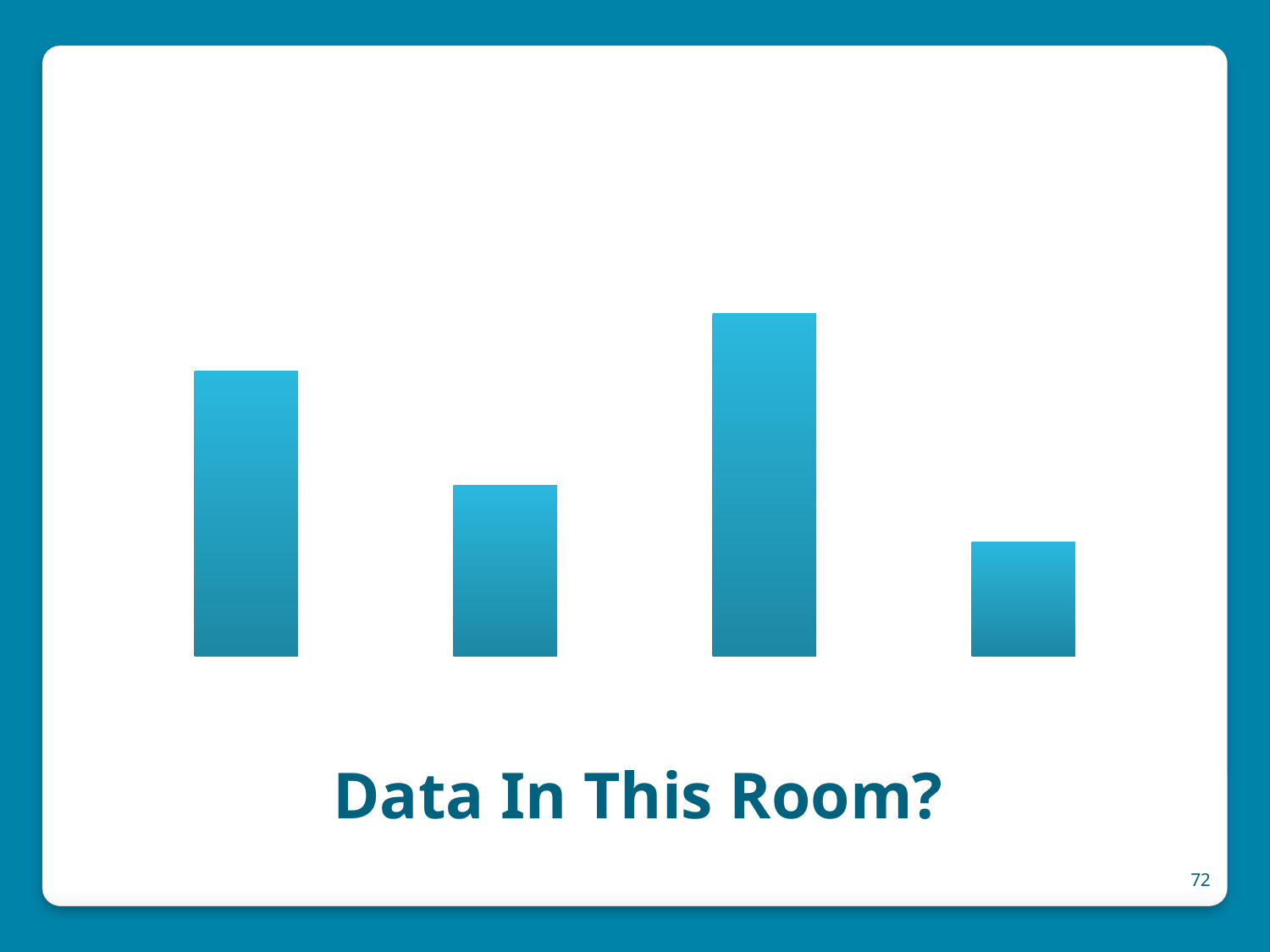
Which is taller, the second bar or the fourth bar? the second bar Which bar is the tallest, counting from the left? the third bar How many bars does the chart show? 4 What kind of chart is shown on the slide? bar chart Which bar is the shortest, counting from the left? the fourth bar Which is taller, the first bar or the second bar? the first bar What is the title text shown below the chart? Data In This Room? Does the chart display any axis labels or data values? No